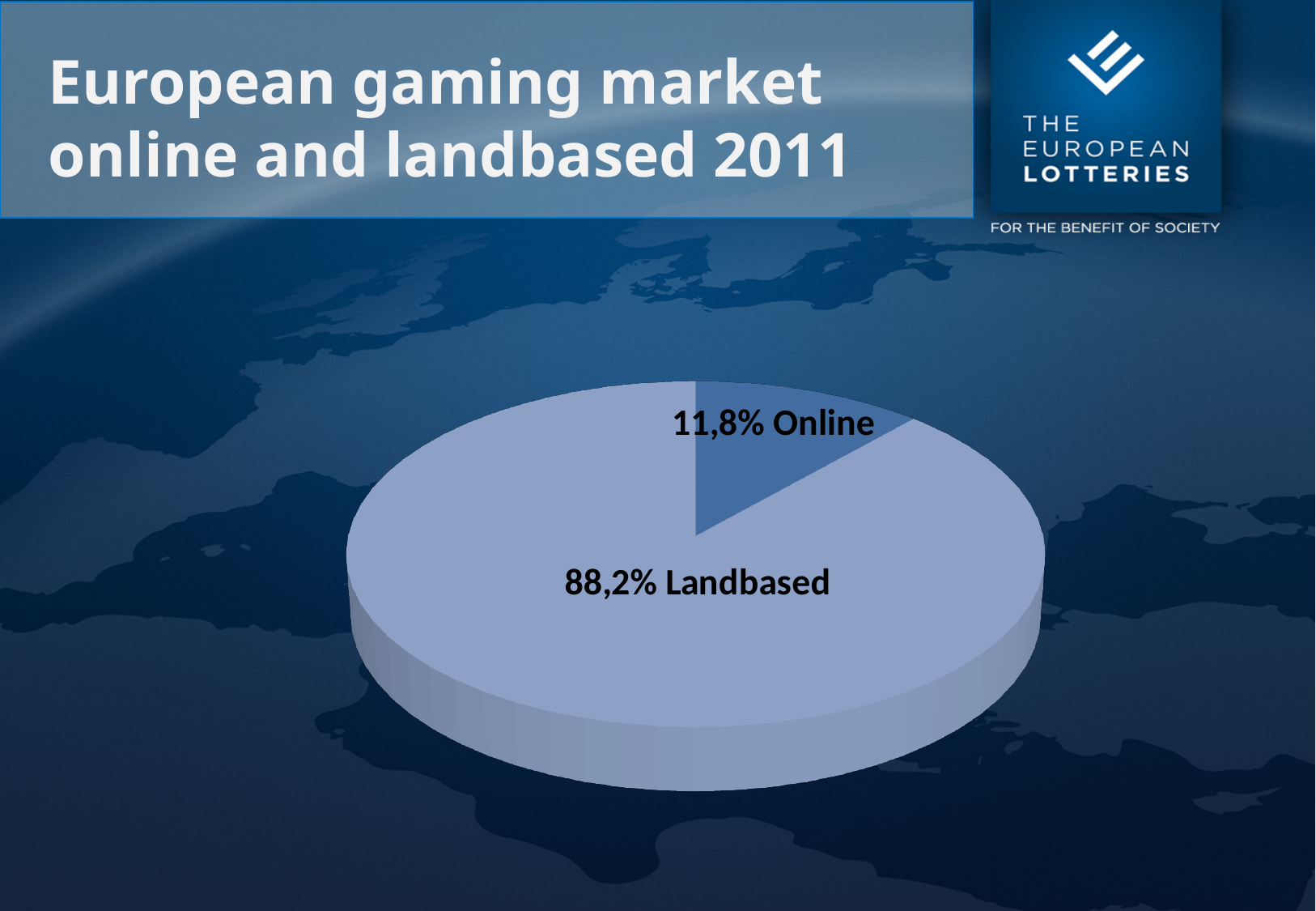
What share of the European gaming market in 2011 was Online? 11,8% How many slices does the pie chart have? 2 What kind of chart is shown on the slide? Pie chart Which slice is drawn in the darker blue colour? Online Which is larger, the Online share or the Landbased share? Landbased Which segment has the largest share of the pie? Landbased What is the difference in percentage points between the Landbased and Online shares? 76,4 What is the title of the slide? European gaming market online and landbased 2011 What is the total of the two slices shown in the pie chart? 100% Which segment has the smallest share of the pie? Online What share of the European gaming market in 2011 was Landbased? 88,2%